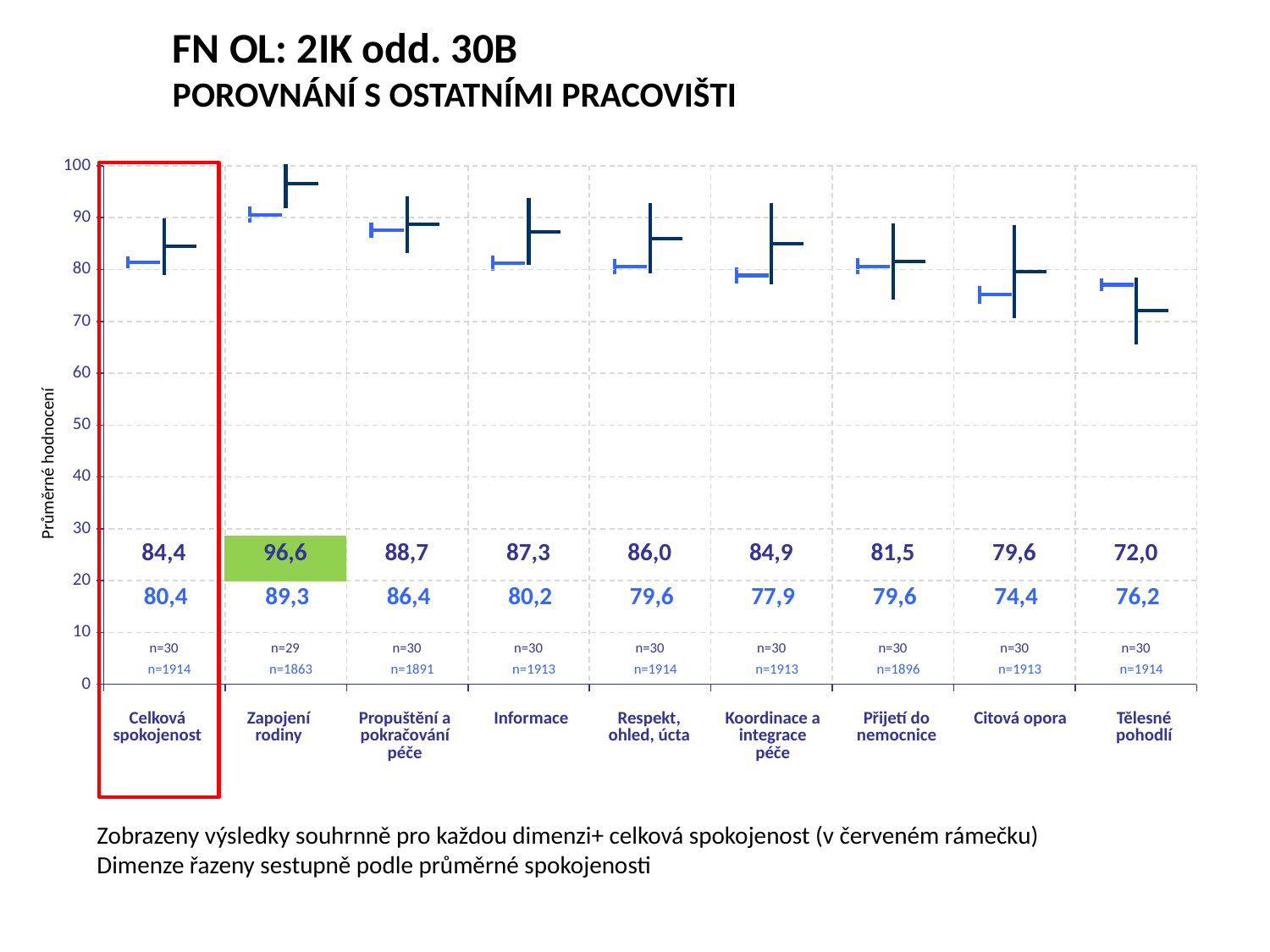
Which category is enclosed in the red frame? Celková spokojenost What is the light blue (lower) value for Celková spokojenost? 80,4 What is the dark navy (upper) value for Zapojení rodiny? 96,6 What is the n value printed in dark text under Zapojení rodiny? n=29 Which is larger for Tělesné pohodlí: the dark navy (upper) value or the light blue (lower) value? the light blue (lower) value, 76,2 Which category has the lowest light blue (lower) value? Citová opora What is the dark navy (upper) value for Tělesné pohodlí? 72,0 What is the light blue (lower) value for Koordinace a integrace péče? 77,9 Which category has the highest dark navy (upper) value? Zapojení rodiny Which category has the lowest dark navy (upper) value? Tělesné pohodlí How many categories are shown on the x axis? 9 What is the difference between the dark navy and light blue values for Zapojení rodiny? 7,3